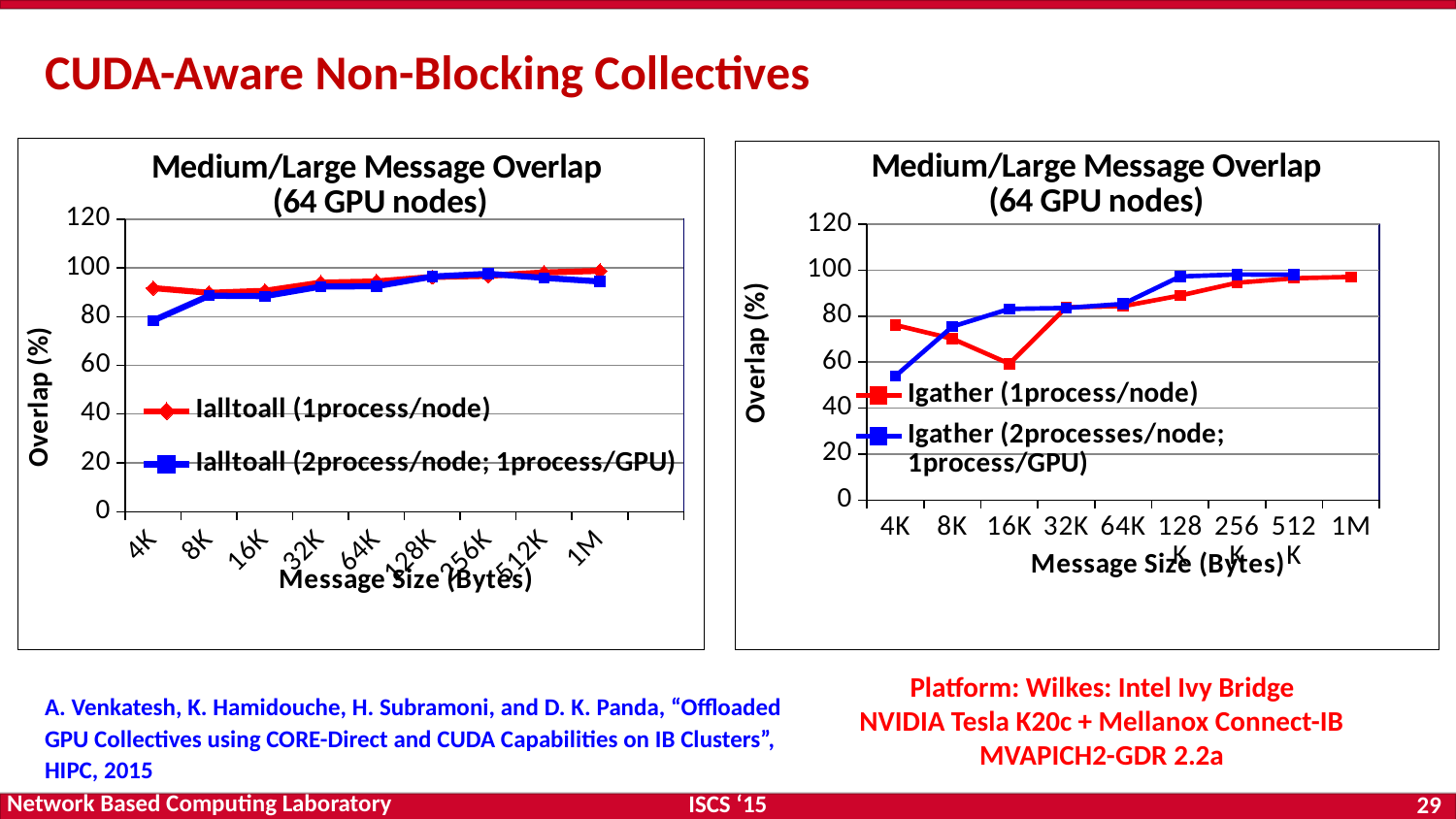
In the left chart, at which message size is the overlap for Ialltoall (2process/node; 1process/GPU) lowest? 4K How many message sizes are plotted along the x axis of the left chart? 9 In the right chart, is the overlap for Igather (2processes/node; 1process/GPU) at 4K greater or less than 60? less In the left chart, is the overlap for Ialltoall (1process/node) at 4K greater or less than 80? greater How many series does the legend of the right chart list? 2 In the right chart, which series has the higher overlap at 16K? Igather (2processes/node; 1process/GPU) What type of chart is the left chart on the slide? line chart How many series does the legend of the left chart list? 2 In the left chart, is the overlap for Ialltoall (2process/node; 1process/GPU) at 4K greater or less than 80? less In the right chart, does the overlap for Igather (2processes/node; 1process/GPU) generally rise or fall as message size increases? rise In the left chart, which series has the higher overlap at 4K? Ialltoall (1process/node) In the right chart, at which message size is the overlap for Igather (1process/node) lowest? 16K